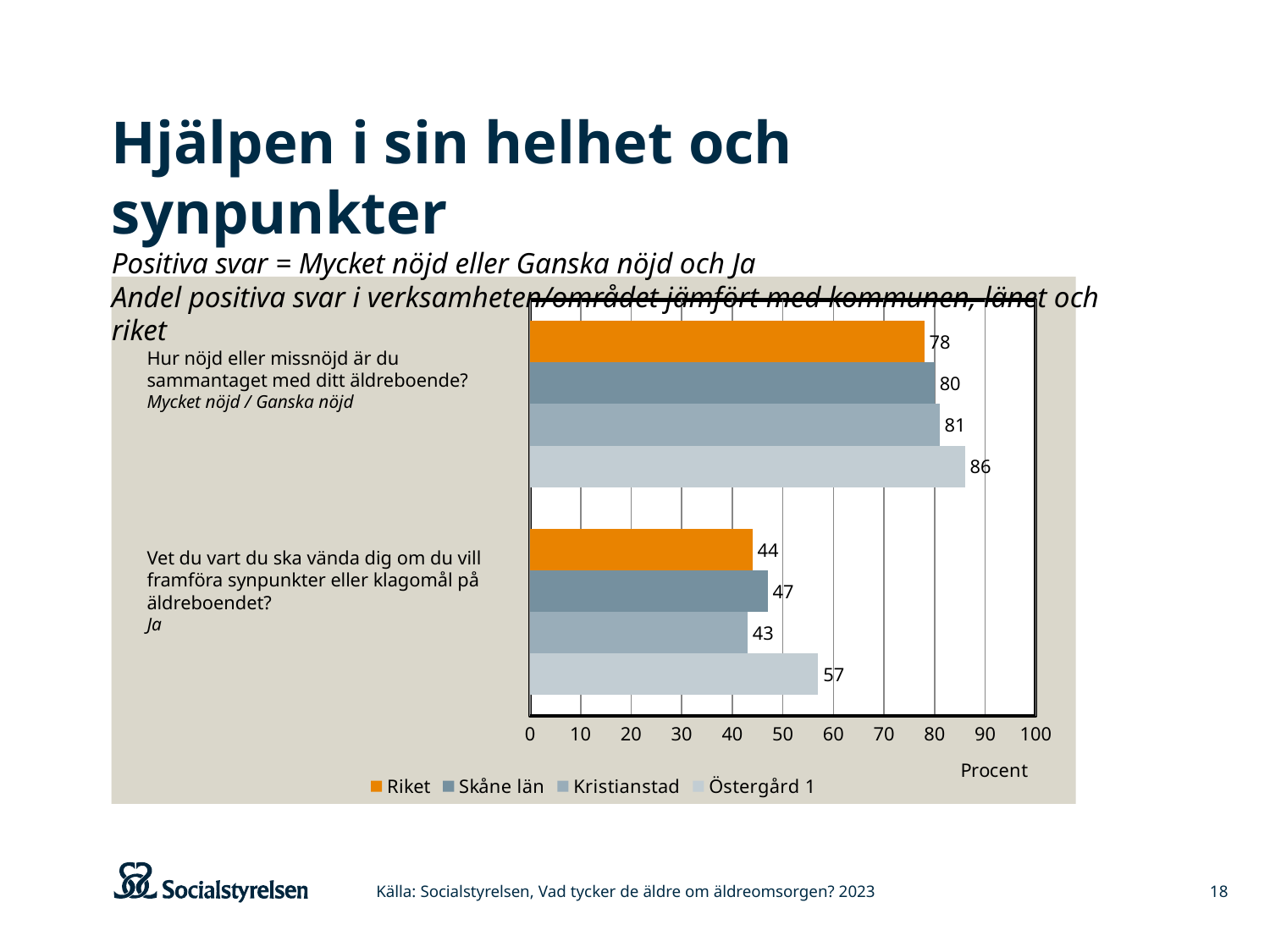
Which series has the highest value on the question about knowing where to turn with synpunkter eller klagomål? Östergård 1 Which series has the lowest value on the question about overall satisfaction with the äldreboende? Riket What kind of chart is shown on the slide? Bar chart What is the label of the x axis in the chart? Procent What value is shown for Riket on the question about knowing where to turn with synpunkter eller klagomål (Ja)? 44 Which is larger on the question about knowing where to turn with synpunkter eller klagomål: Skåne län or Kristianstad? Skåne län What value is shown for Östergård 1 on the question about overall satisfaction with the äldreboende (Mycket nöjd / Ganska nöjd)? 86 What is the difference between Östergård 1 and Riket on the question about knowing where to turn with synpunkter eller klagomål? 13 What value is shown for Skåne län on the question about overall satisfaction with the äldreboende? 80 What value is shown for Kristianstad on the question about knowing where to turn with synpunkter eller klagomål? 43 How many survey questions (categories) are plotted in the chart? 2 How many series does the legend list? 4